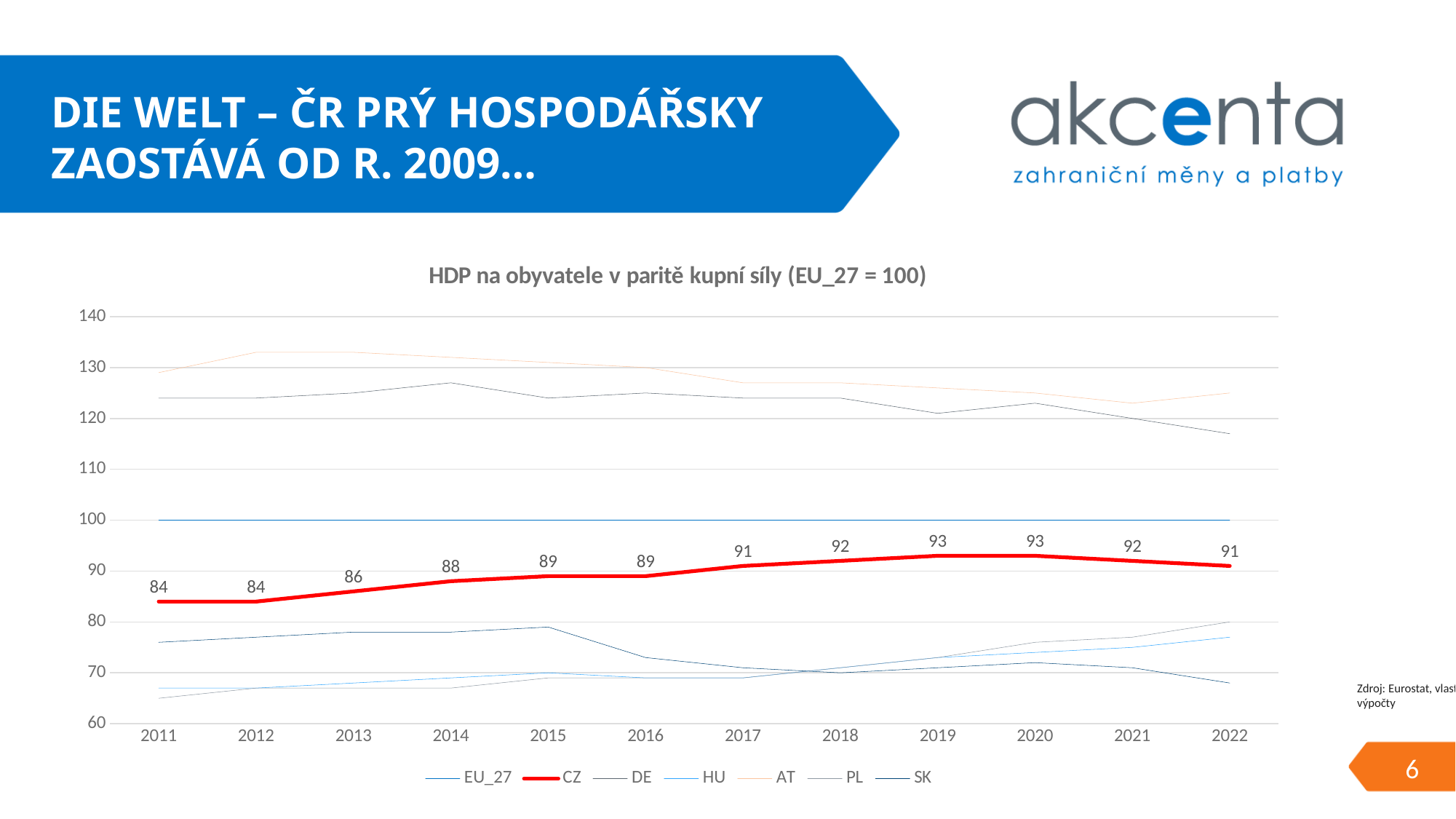
By how much did the CZ value change between 2011 and 2022? 7 What is the title of the chart? HDP na obyvatele v paritě kupní síly (EU_27 = 100) What is the value for CZ in 2011? 84 What is the highest value shown for the CZ series? 93 What is the value for CZ in 2022? 91 What is the value for CZ in 2019? 93 How many series does the legend list? 7 What is the lowest value shown for the CZ series? 84 Which year has the larger CZ value, 2017 or 2021? 2021 What kind of chart is shown on the slide? line chart How many years are shown on the x axis? 12 Does the CZ series rise or fall from 2011 to 2019? rise